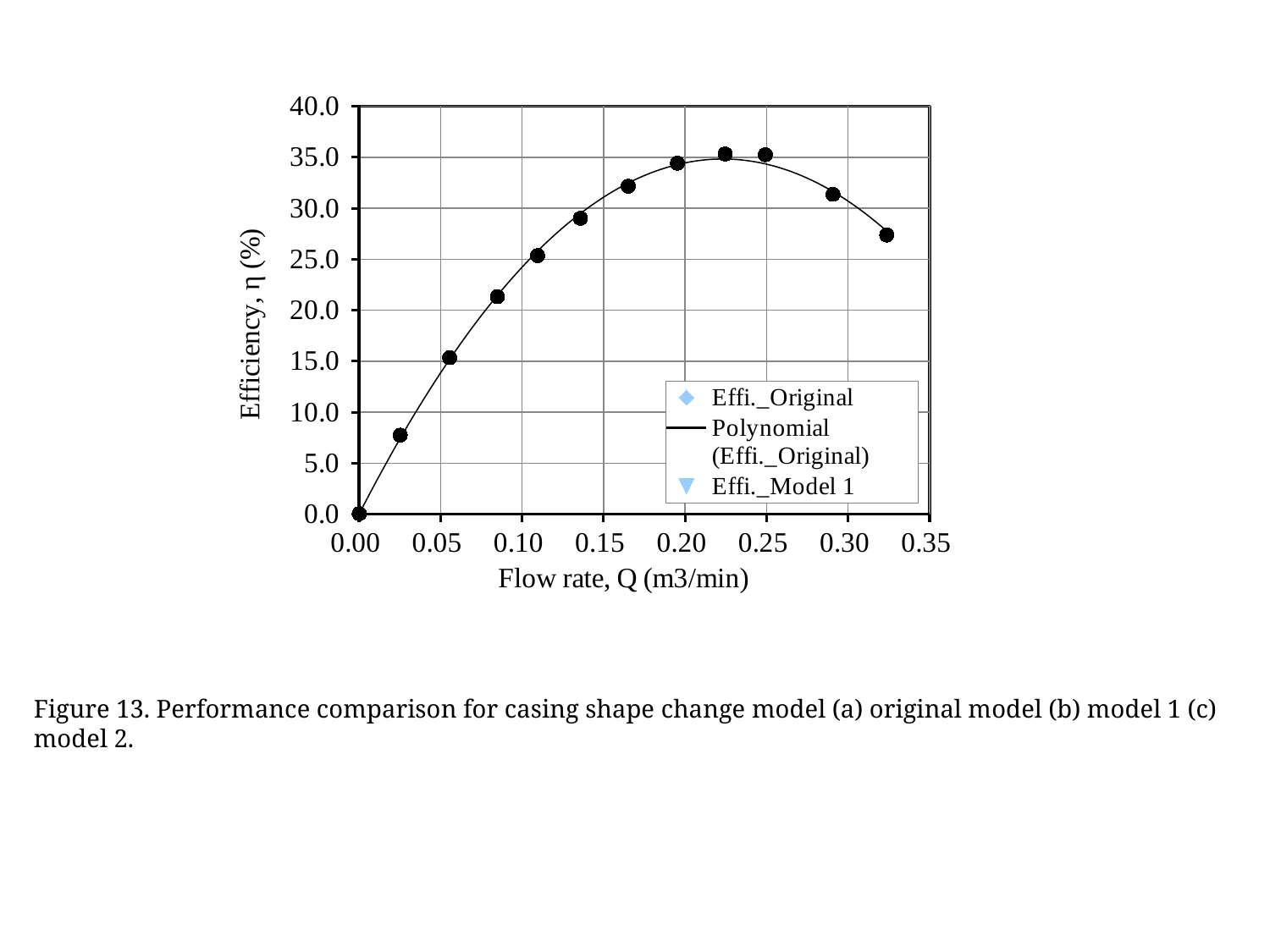
How does efficiency change as flow rate increases from 0.00 to 0.35 m3/min? It rises to a peak around 0.22–0.25 m3/min and then falls What is the title of the horizontal axis of the chart? Flow rate, Q (m3/min) What is the maximum value shown on the vertical axis of the chart? 40.0 What is the title of the vertical axis of the chart? Efficiency, η (%) How many entries does the chart's legend list? 3 Is the efficiency at a flow rate of about 0.03 m3/min greater or less than 10.0? less How many data points are plotted on the chart? 12 Is the efficiency at the highest plotted flow rate (about 0.325 m3/min) greater or less than 30.0? less What kind of chart is shown on the slide? Scatter chart with a polynomial trendline Is the efficiency at a flow rate of about 0.11 m3/min greater or less than 20.0? greater Which is larger: the efficiency at a flow rate of about 0.06 m3/min or at about 0.29 m3/min? About 0.29 m3/min